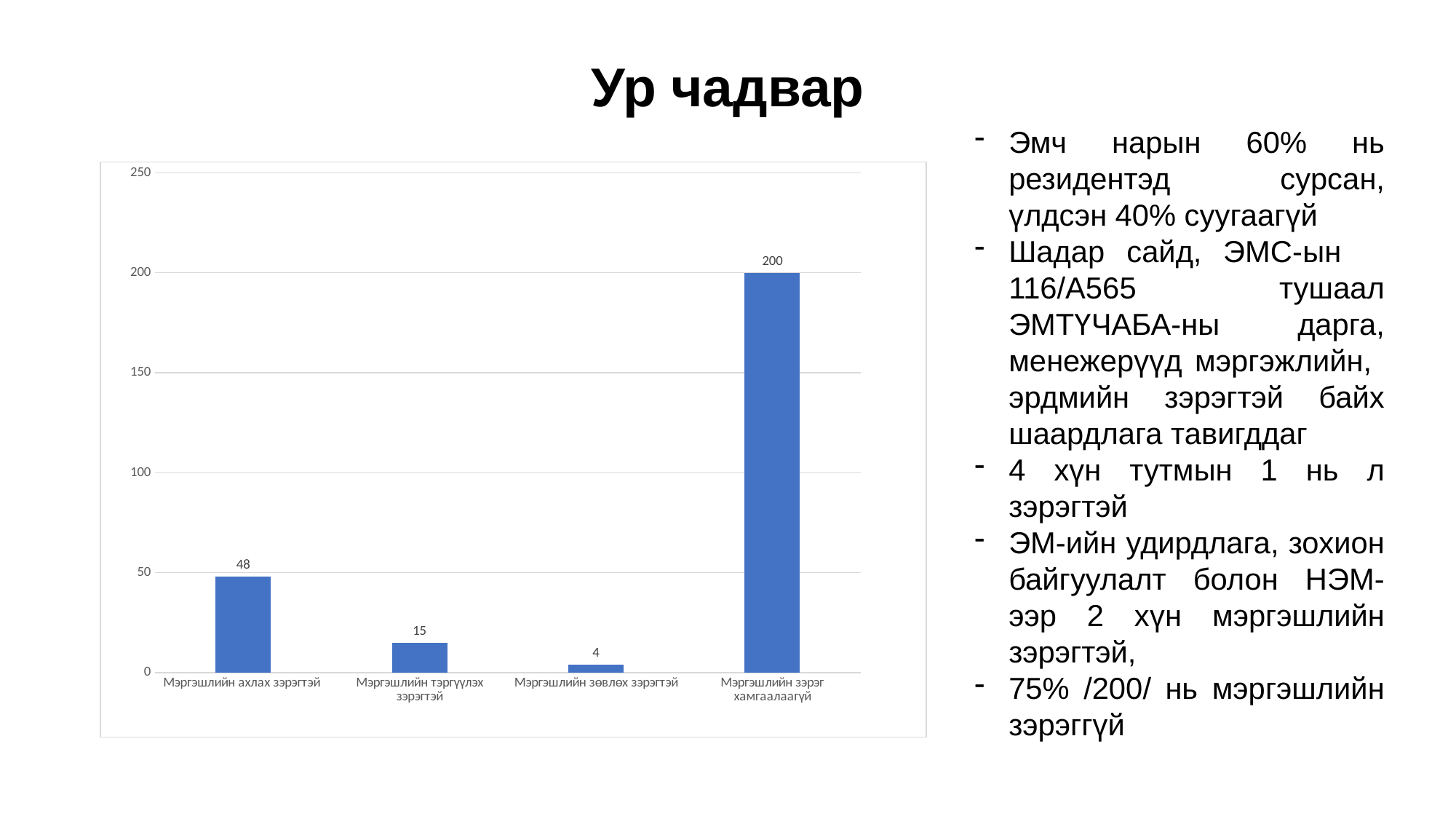
Which is larger, the value for Мэргэшлийн тэргүүлэх зэрэгтэй or the value for Мэргэшлийн зөвлөх зэрэгтэй? Мэргэшлийн тэргүүлэх зэрэгтэй What is the value for Мэргэшлийн зөвлөх зэрэгтэй? 4 Which category has the lowest value? Мэргэшлийн зөвлөх зэрэгтэй What is the difference between the values for Мэргэшлийн ахлах зэрэгтэй and Мэргэшлийн тэргүүлэх зэрэгтэй? 33 What kind of chart is shown on the slide? bar chart Which category has the highest value? Мэргэшлийн зэрэг хамгаалаагүй What is the difference between the values for Мэргэшлийн зэрэг хамгаалаагүй and Мэргэшлийн ахлах зэрэгтэй? 152 What is the value for Мэргэшлийн ахлах зэрэгтэй? 48 What is the value for Мэргэшлийн зэрэг хамгаалаагүй? 200 How many categories are shown on the x axis? 4 Is the value for Мэргэшлийн ахлах зэрэгтэй greater or less than 50? less What is the value for Мэргэшлийн тэргүүлэх зэрэгтэй? 15